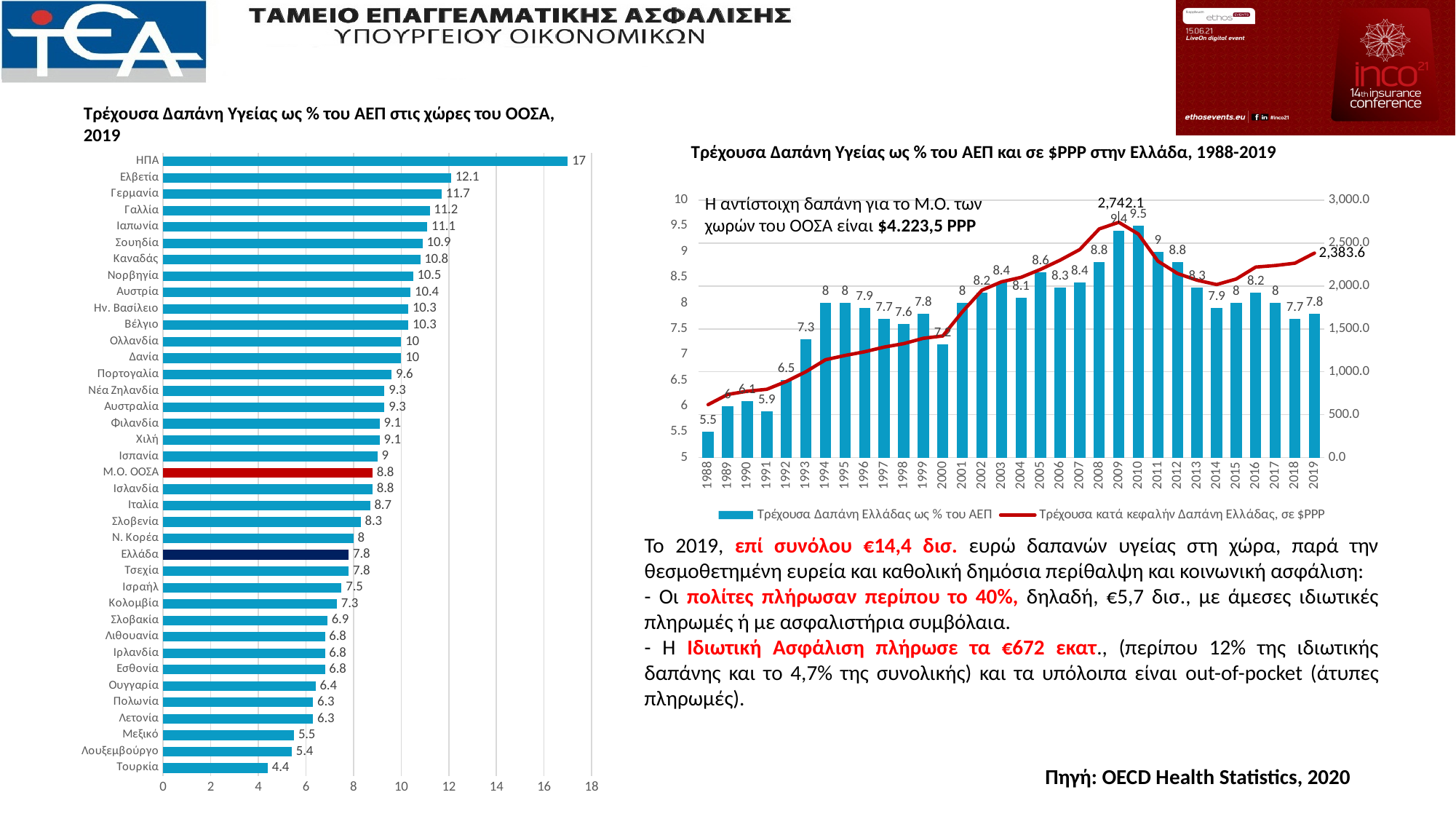
In the right chart (Τρέχουσα Δαπάνη Υγείας ως % του ΑΕΠ και σε $PPP στην Ελλάδα, 1988-2019), what is the value of the bar for 2010? 9.5 In the left chart, which country has the highest current health expenditure as % of GDP? ΗΠΑ In the left chart (Τρέχουσα Δαπάνη Υγείας ως % του ΑΕΠ στις χώρες του ΟΟΣΑ, 2019), what is the value for Ελλάδα? 7.8 What type of chart is the left chart? Bar chart In the right chart, what is the value of the $PPP line labelled for 2019? 2,383.6 In the left chart, which country has the lowest value? Τουρκία In the left chart, which is larger, the value for Γερμανία or the value for Γαλλία? Γερμανία How many series does the legend of the right chart list? 2 How many bars are plotted in the left chart? 38 In the right chart, what is the difference between the bar values for 2009 and 2019? 1.6 In the left chart, what is the difference between the value for ΗΠΑ and the value for Ελβετία? 4.9 In the left chart, what is the value shown for Μ.Ο. ΟΟΣΑ? 8.8